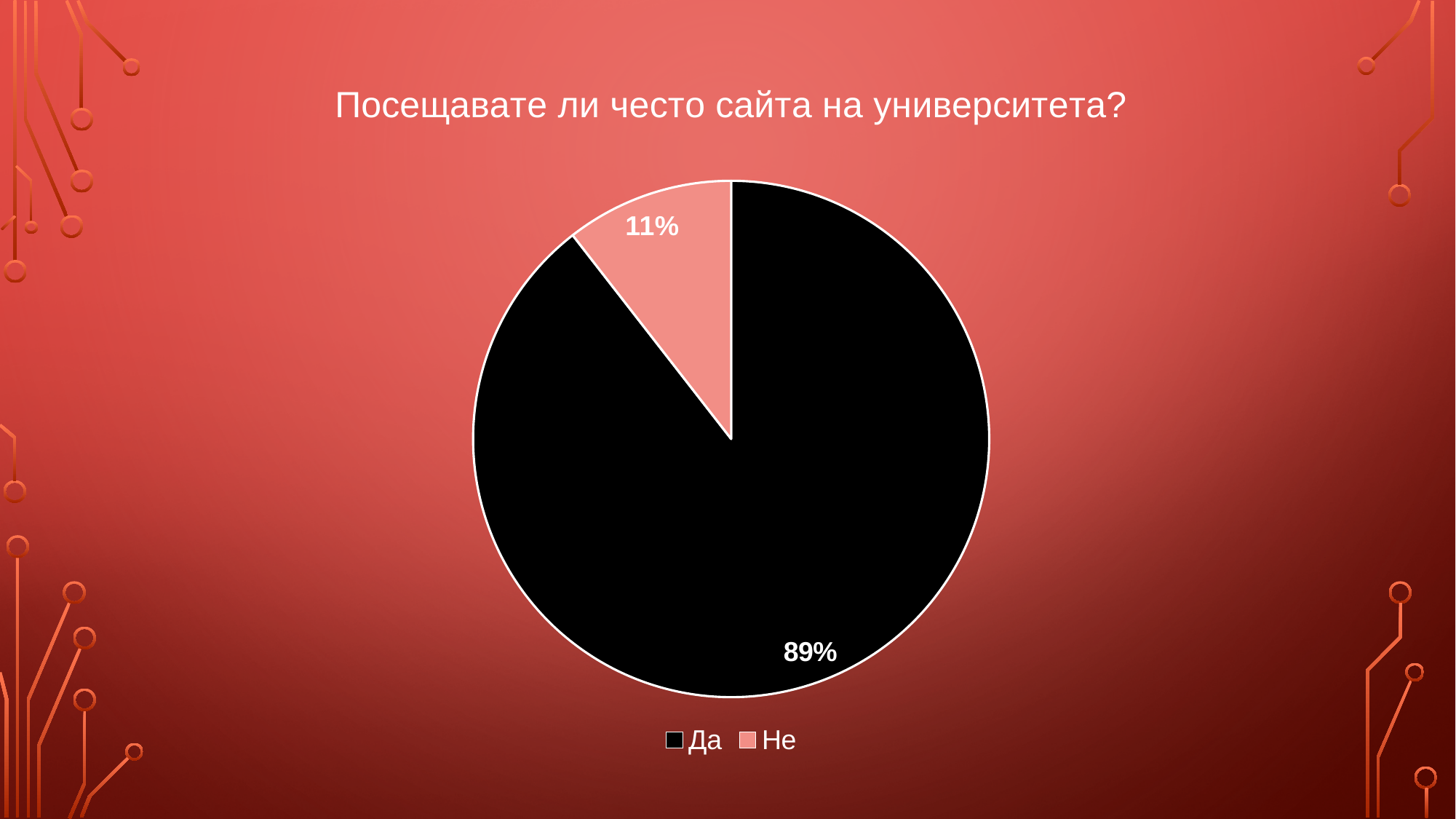
What percentage of the pie is labelled for "Да"? 89% What colour is the "Не" slice? pink Which category has the largest slice of the pie? Да How many slices does the pie chart have? 2 What is the difference in percentage points between the "Да" and "Не" slices? 78 Which category has the smallest slice of the pie? Не Which slice is larger, "Да" or "Не"? Да What share of the pie does the "Да" slice take? 89% What kind of chart is shown on the slide? pie chart How many entries does the legend list? 2 What percentage of the pie is labelled for "Не"? 11% What is the title of the chart? Посещавате ли често сайта на университета?